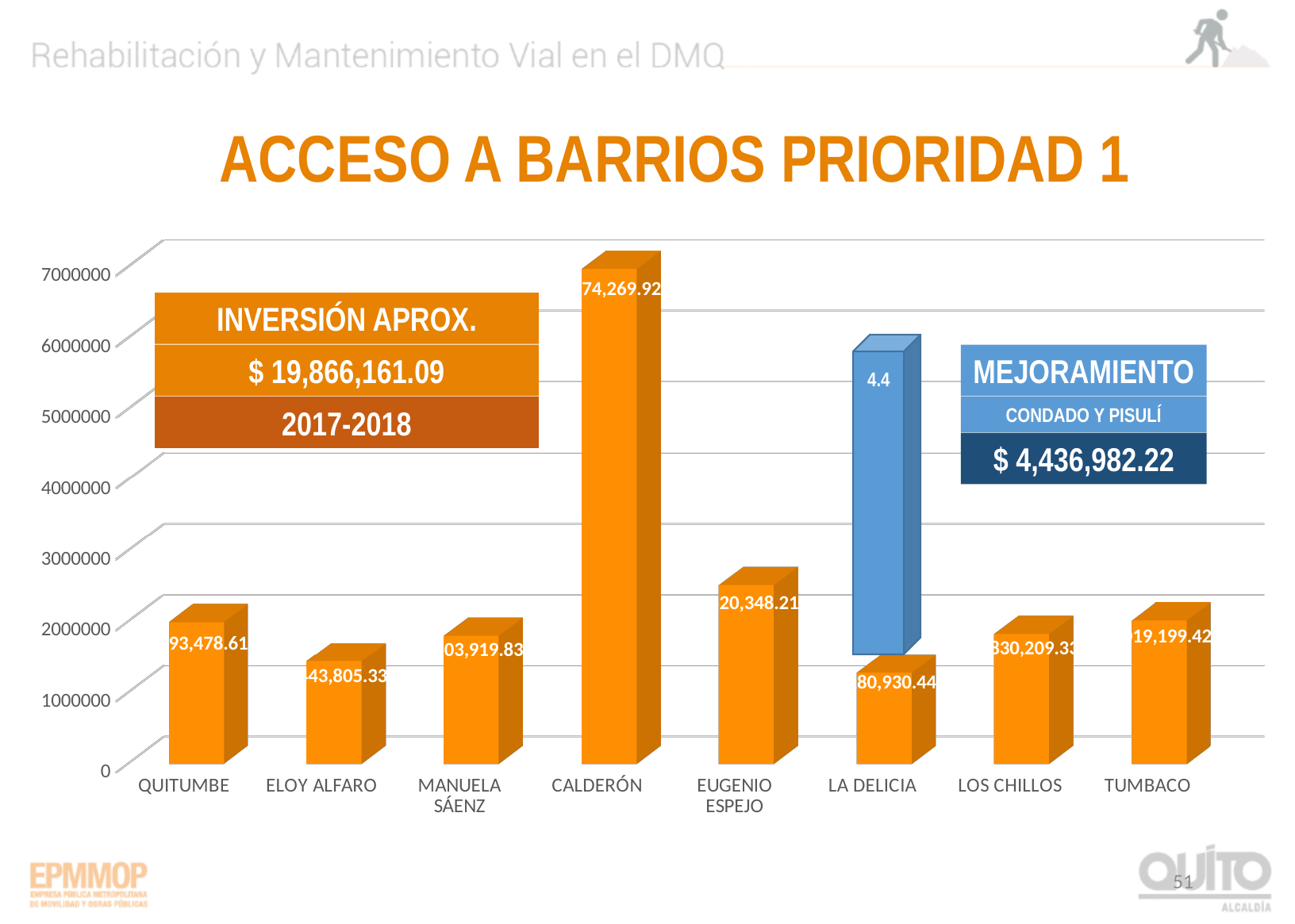
Is the value for EUGENIO ESPEJO greater or less than 2000000? greater Which zone has the highest orange bar in the chart? CALDERÓN Which is larger, the value for CALDERÓN or the value for EUGENIO ESPEJO? CALDERÓN What is the title of the chart on the slide? ACCESO A BARRIOS PRIORIDAD 1 Is the value for TUMBACO greater or less than 1000000? greater Is the value for ELOY ALFARO greater or less than 2000000? less What approximate investment amount (INVERSIÓN APROX.) is shown in the orange box on the chart? $ 19,866,161.09 What kind of chart is shown on the slide? bar chart Which is larger, the value for QUITUMBE or the value for ELOY ALFARO? QUITUMBE How many administrative zones (categories) are shown on the x axis of the chart? 8